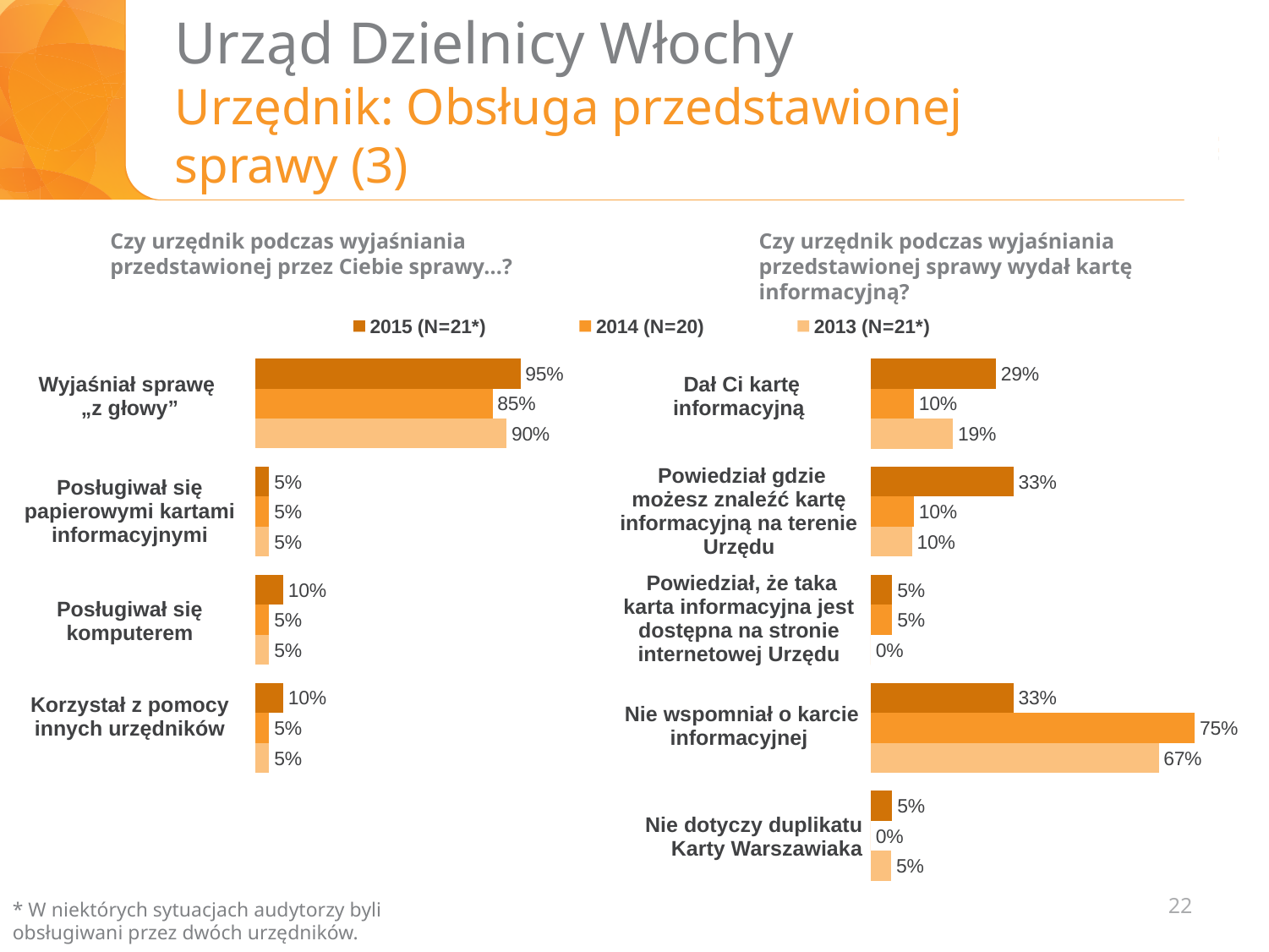
What type of chart is used on the slide? Bar chart In the left chart, which category has the highest value for 2013 (N=21*)? Wyjaśniał sprawę „z głowy” How many categories are shown in the right chart ("Czy urzędnik podczas wyjaśniania przedstawionej sprawy wydał kartę informacyjną?")? 5 In the right chart, what is the difference between the 2015 and 2014 values for "Powiedział gdzie możesz znaleźć kartę informacyjną na terenie Urzędu"? 23 percentage points In the left chart, what is the value for "Posługiwał się komputerem" in 2014 (N=20)? 5% In the right chart, what is the value for "Nie wspomniał o karcie informacyjnej" in 2014 (N=20)? 75% How many series does the legend list for the charts on the slide? 3 In the right chart, what is the value for "Nie dotyczy duplikatu Karty Warszawiaka" in 2014 (N=20)? 0% In the right chart, what is the value for "Dał Ci kartę informacyjną" in 2013 (N=21*)? 19% In the left chart ("Czy urzędnik podczas wyjaśniania przedstawionej przez Ciebie sprawy...?"), what is the value for "Wyjaśniał sprawę „z głowy”" in 2015 (N=21*)? 95% In the left chart, what is the difference between the 2015 and 2014 values for "Wyjaśniał sprawę „z głowy”"? 10 percentage points In the right chart, which is larger for "Nie wspomniał o karcie informacyjnej": the 2015 value or the 2013 value? 2013